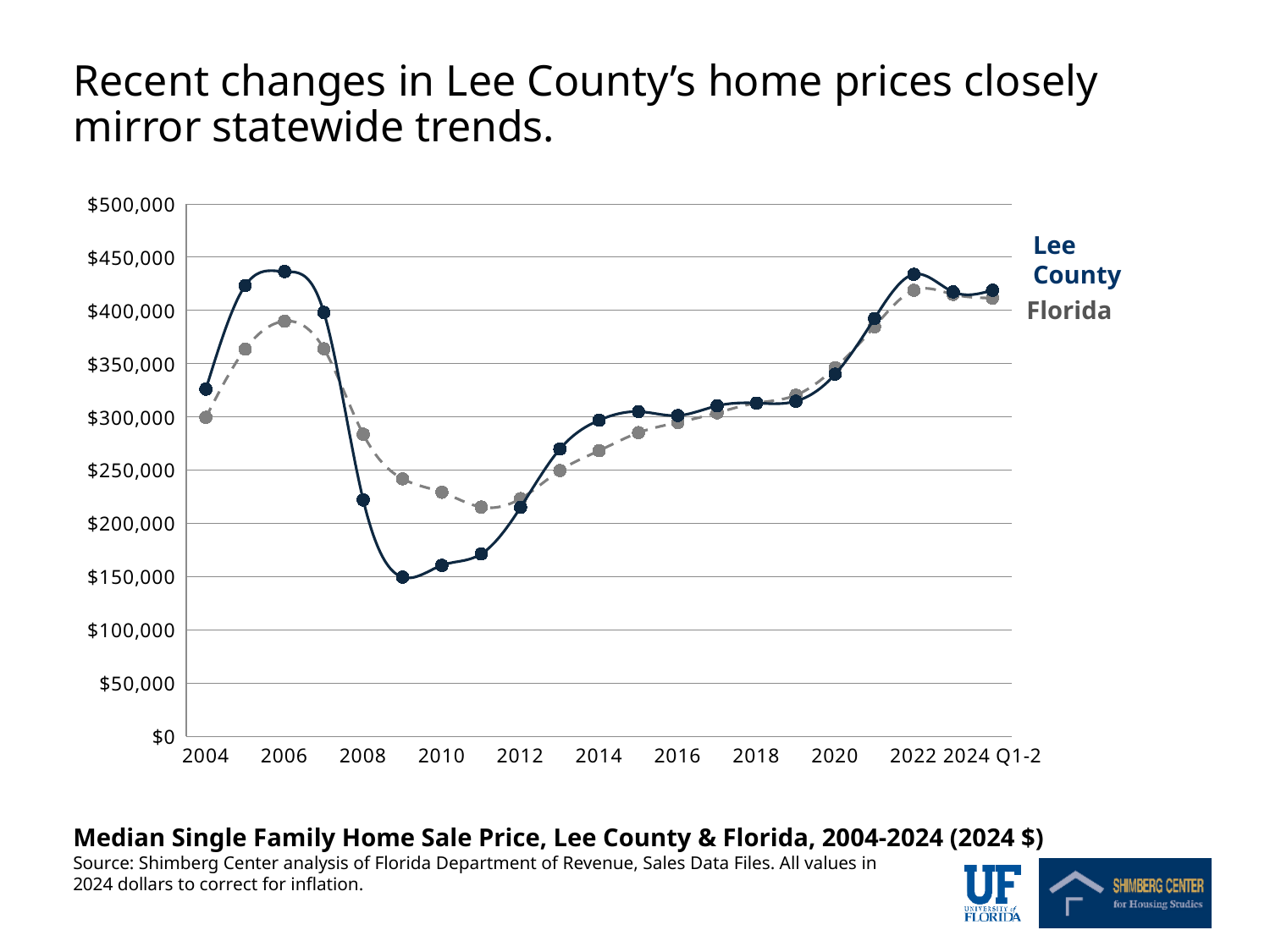
In 2006, which series has the higher value, Lee County or Florida? Lee County Is the Florida value for 2009 greater or less than $250,000? less Is the Lee County value for 2006 greater or less than $400,000? greater In which year does the Lee County line reach its highest value? 2006 What is the title of the chart? Median Single Family Home Sale Price, Lee County & Florida, 2004-2024 (2024 $) Does the Lee County line rise or fall between 2006 and 2009? Fall What kind of chart is shown on the slide? Line chart Is the Lee County value for 2008 greater or less than $200,000? greater Which two series are plotted on the chart? Lee County and Florida In which year does the Lee County line reach its lowest value? 2009 How many series does the chart show? 2 In 2010, which series has the higher value, Lee County or Florida? Florida